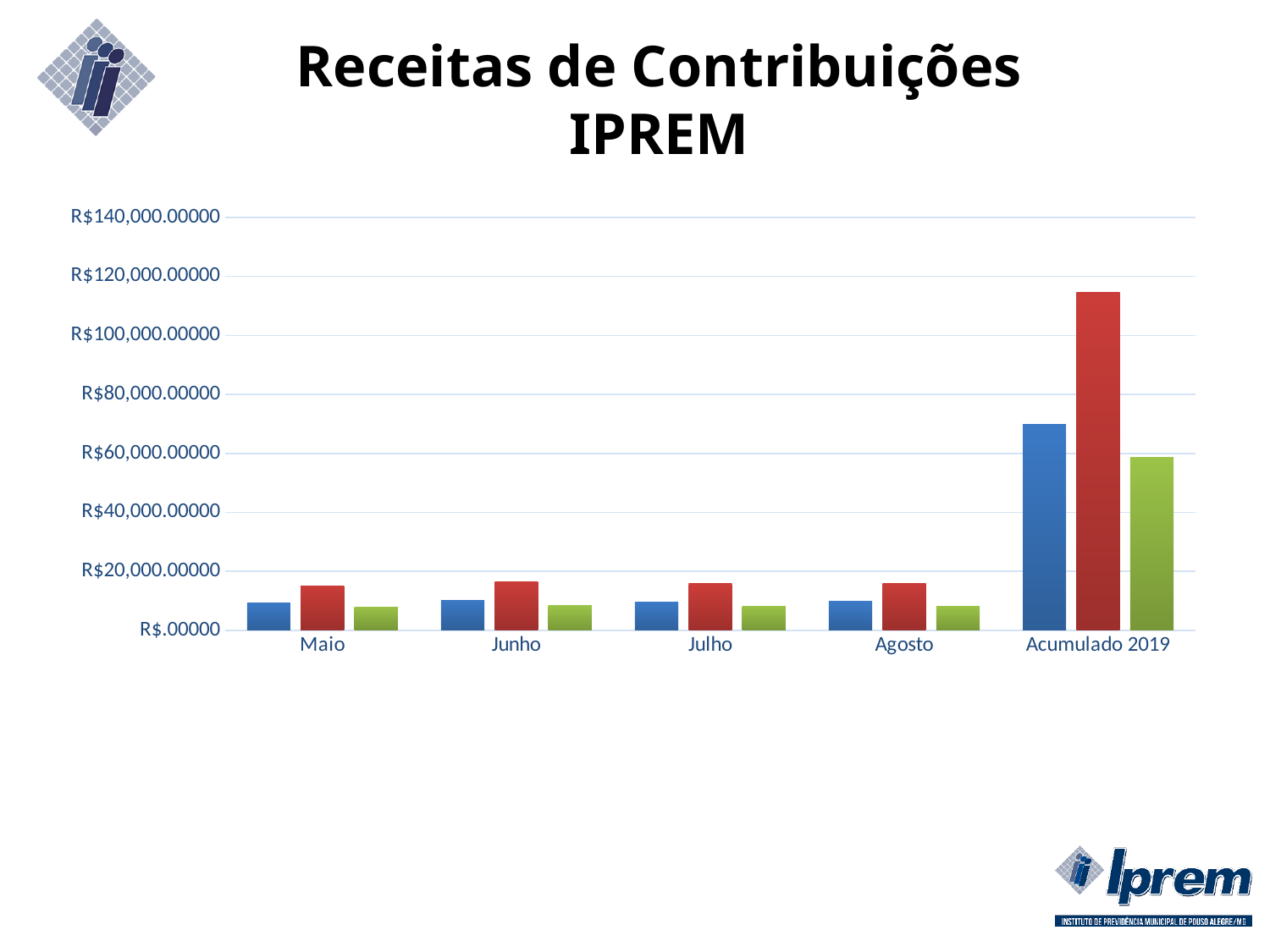
How many categories are shown on the x axis of the chart? 5 Is the value of the green bar for Acumulado 2019 greater or less than R$80,000.00000? less Is the value of the blue bar for Acumulado 2019 greater or less than R$60,000.00000? greater How many bars are shown for each category in the chart? 3 Is the value of the blue bar for Julho greater or less than R$20,000.00000? less For Acumulado 2019, which bar is larger, the blue bar or the green bar? the blue bar For Acumulado 2019, which bar is larger, the red bar or the blue bar? the red bar Which category has the tallest bars in the chart? Acumulado 2019 What is the title of the chart on the slide? Receitas de Contribuições IPREM What kind of chart is shown on the slide? bar chart